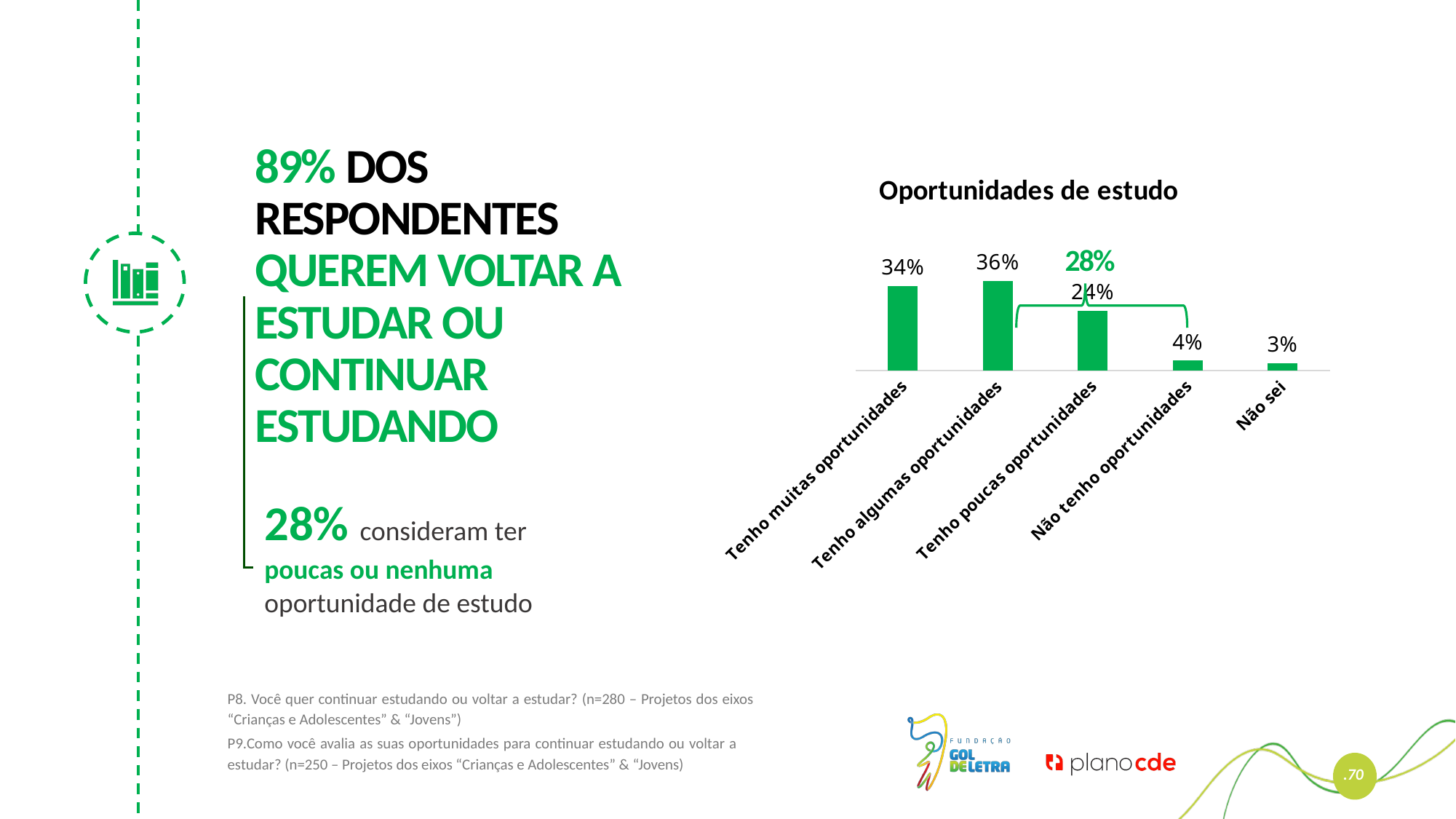
What is the value for "Não tenho oportunidades"? 4% What is the combined value of "Tenho poucas oportunidades" and "Não tenho oportunidades" shown by the bracket? 28% How many categories are shown in the chart? 5 What is the value for "Não sei"? 3% Which category has the highest value in the chart? Tenho algumas oportunidades What is the value for "Tenho algumas oportunidades"? 36% What is the title of the chart? Oportunidades de estudo What type of chart is shown on the slide? Bar chart What is the value for "Tenho poucas oportunidades"? 24% What is the value for "Tenho muitas oportunidades" in the Oportunidades de estudo chart? 34% Which category has the lowest value in the chart? Não sei What is the difference between "Tenho algumas oportunidades" and "Tenho muitas oportunidades"? 2%